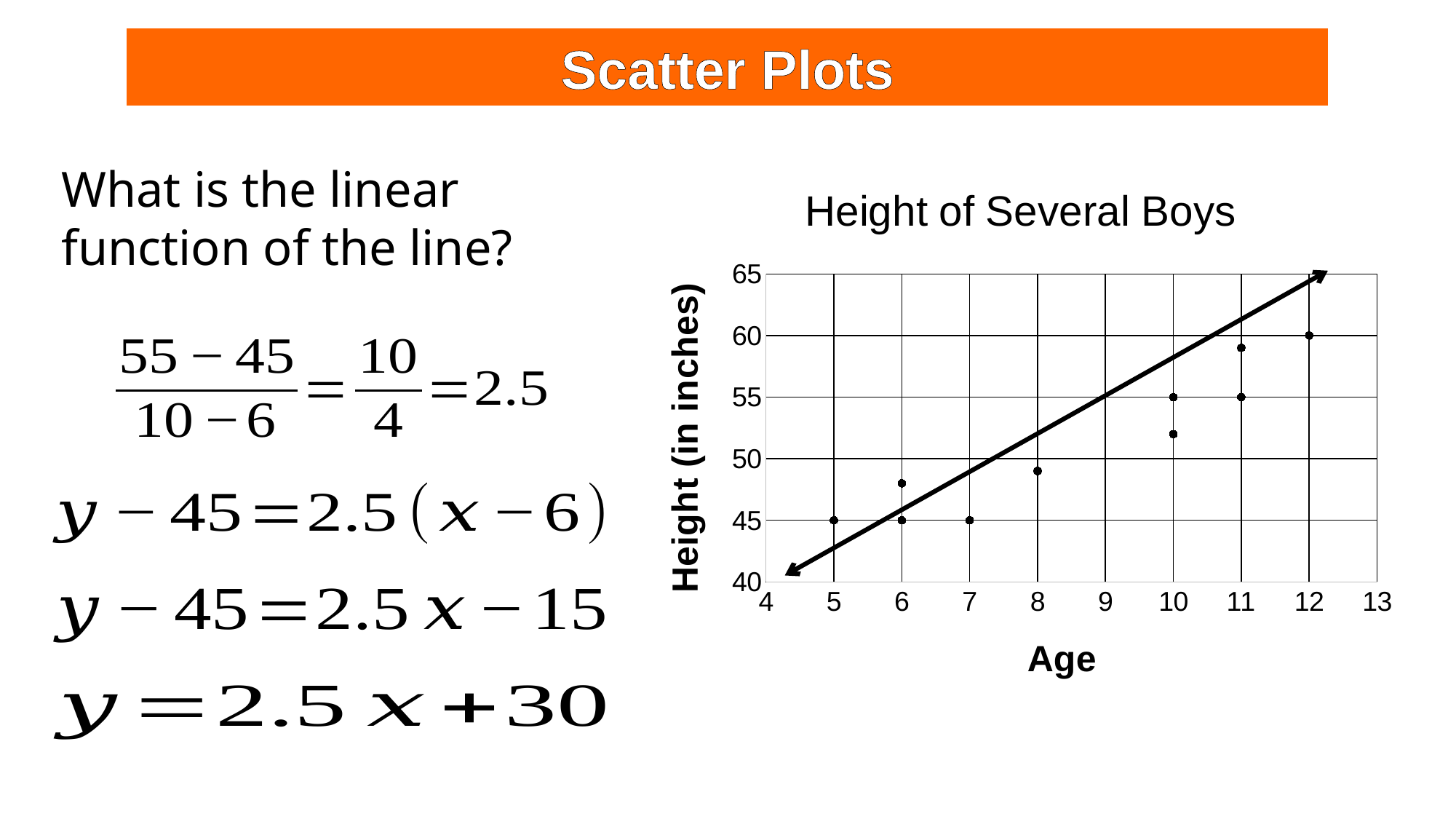
What is the height plotted for the boy aged 7? 45 Do the plotted heights generally rise or fall as age increases? rise What is the height plotted for the boy aged 12? 60 What is the label of the vertical axis of the chart? Height (in inches) At which age is the tallest height plotted? 12 What is the title of the chart? Height of Several Boys Is the height plotted for the boy aged 8 greater or less than 50? less Is the higher of the two points at age 11 greater or less than 55? greater How many data points are plotted on the chart? 10 What is the height plotted for the boy aged 5? 45 Which is larger, the height plotted at age 12 or the height plotted at age 5? age 12 What kind of chart is shown on the slide? scatter plot